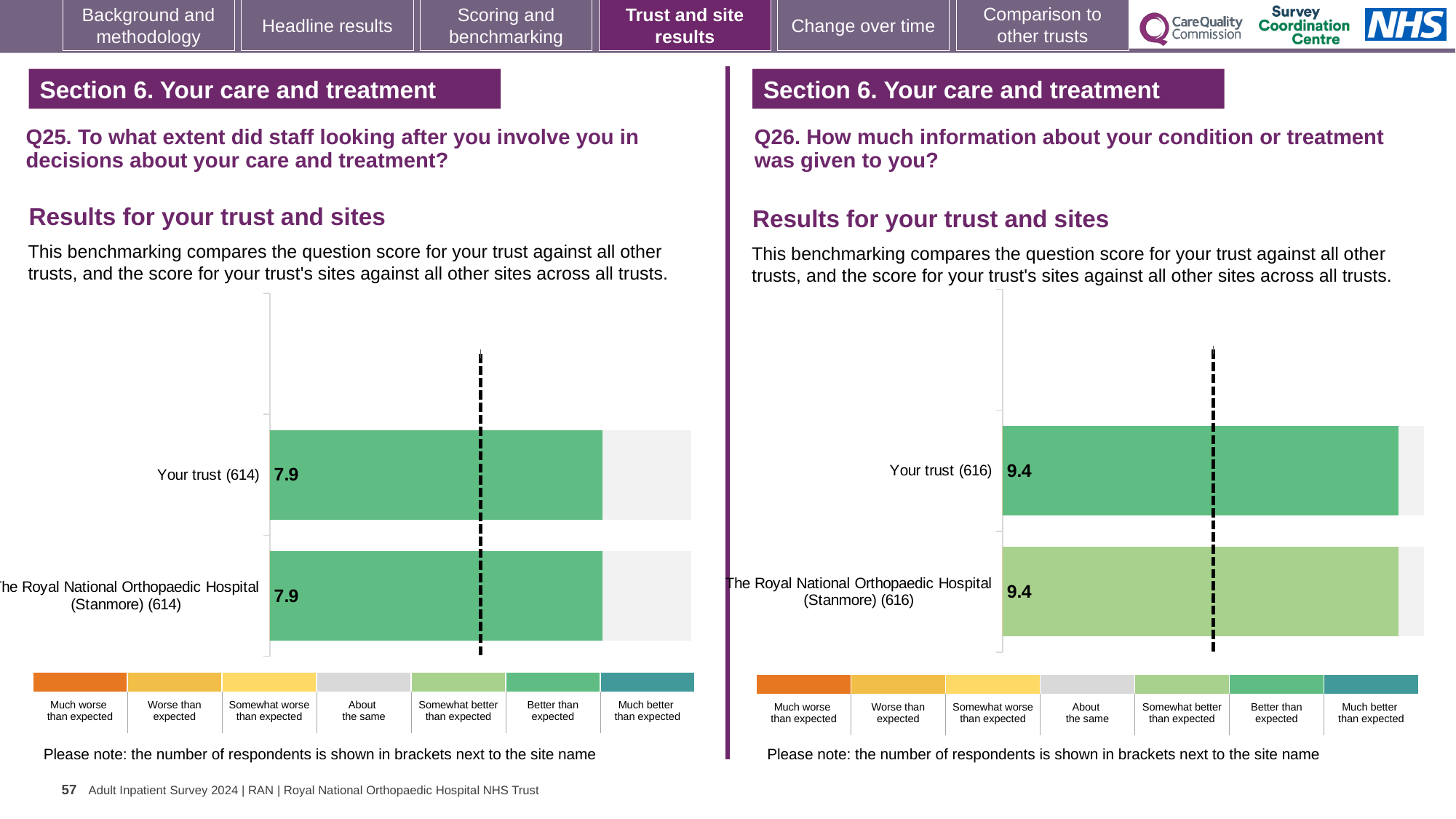
On the Q26 chart (right), what is the difference between the score for Your trust and the score for The Royal National Orthopaedic Hospital (Stanmore)? 0 How many bars are plotted on the Q25 chart (left)? 2 On the Q25 chart (left), what is the score for Your trust (614)? 7.9 How many respondents are shown in brackets for Your trust on the Q26 chart (right)? 616 On the Q25 chart (left), what is the score for The Royal National Orthopaedic Hospital (Stanmore) (614)? 7.9 On the Q26 chart (right), which benchmark category does the colour of the bar for The Royal National Orthopaedic Hospital (Stanmore) (616) correspond to in the legend? Somewhat better than expected How many categories does the colour legend below the Q25 chart (left) list? 7 How many bars are plotted on the Q26 chart (right)? 2 On the Q26 chart (right), what is the score for Your trust (616)? 9.4 On the Q26 chart (right), what is the score for The Royal National Orthopaedic Hospital (Stanmore) (616)? 9.4 On the Q25 chart (left), what is the difference between the score for Your trust and the score for The Royal National Orthopaedic Hospital (Stanmore)? 0 What type of chart is used for the Q25 results on the left? Bar chart